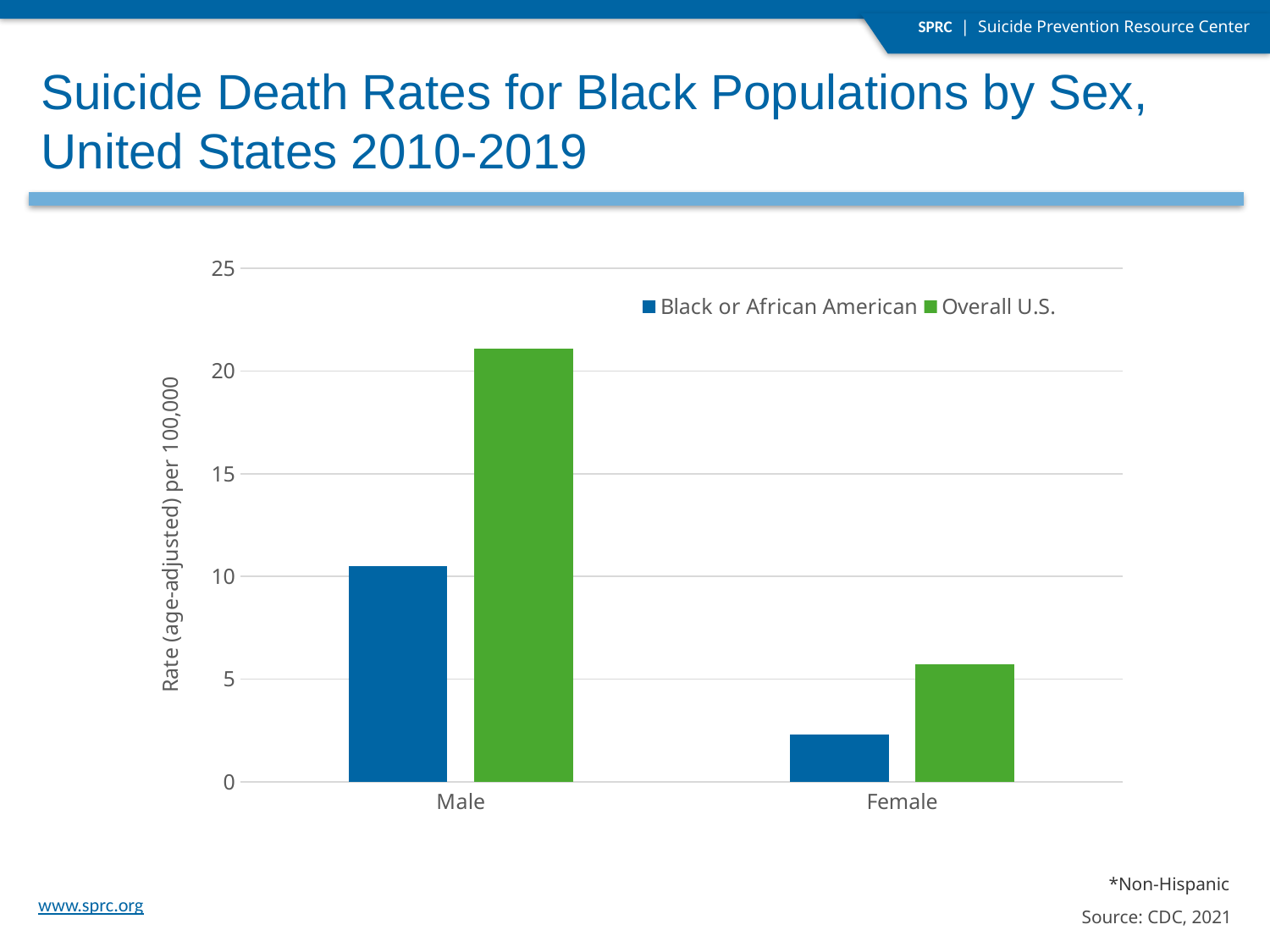
Which category has the highest Overall U.S. suicide death rate? Male Which series is shown in green? Overall U.S. What kind of chart is shown on the slide? bar chart Is the Black or African American rate for Male greater or less than 15? less Is the Overall U.S. rate for Female greater or less than 5? greater Is the Black or African American rate for Female greater or less than 5? less For Male, which is larger: the Black or African American rate or the Overall U.S. rate? Overall U.S. How many series does the legend list? 2 How many categories are shown on the x axis? 2 Which category has the lowest Black or African American suicide death rate? Female What does the y axis measure? Rate (age-adjusted) per 100,000